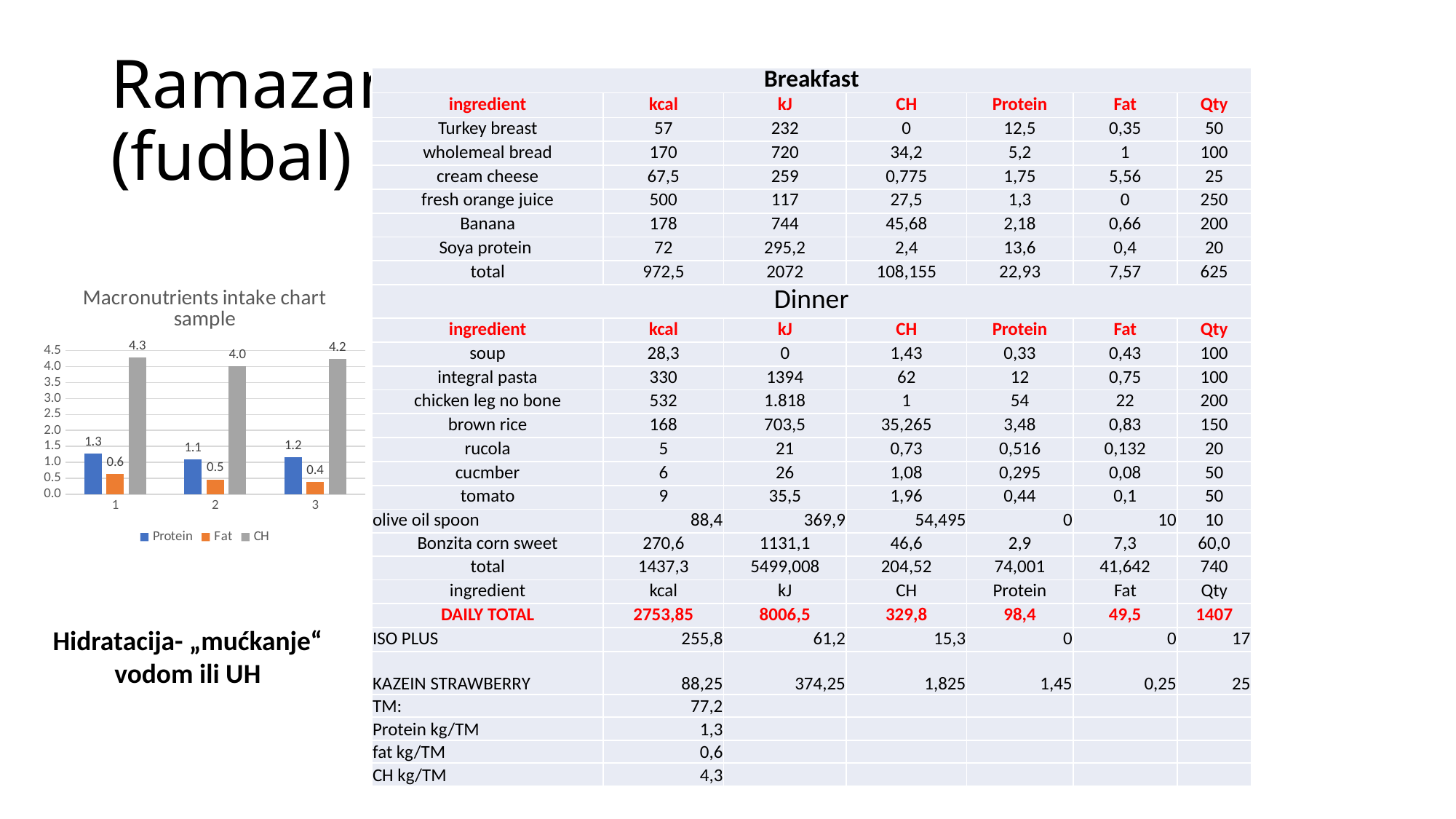
In the Macronutrients intake chart sample, what is the difference between the CH value for category 1 and the CH value for category 2? 0.3 How many categories are shown on the x axis of the Macronutrients intake chart sample? 3 What is the value of Fat for category 3 in the Macronutrients intake chart sample? 0.4 What kind of chart is the Macronutrients intake chart sample? bar chart In the Macronutrients intake chart sample, which category has the highest CH value? 1 What is the value of CH for category 2 in the Macronutrients intake chart sample? 4.0 In the Macronutrients intake chart sample, is the Protein value for category 2 larger or smaller than the Protein value for category 3? smaller Which series in the Macronutrients intake chart sample is shown in grey? CH How many series does the legend of the Macronutrients intake chart sample list? 3 In the Macronutrients intake chart sample, which category has the lowest Fat value? 3 In the Macronutrients intake chart sample, is the CH value for category 3 greater or less than 4.0? greater What is the value of Protein for category 1 in the Macronutrients intake chart sample? 1.3